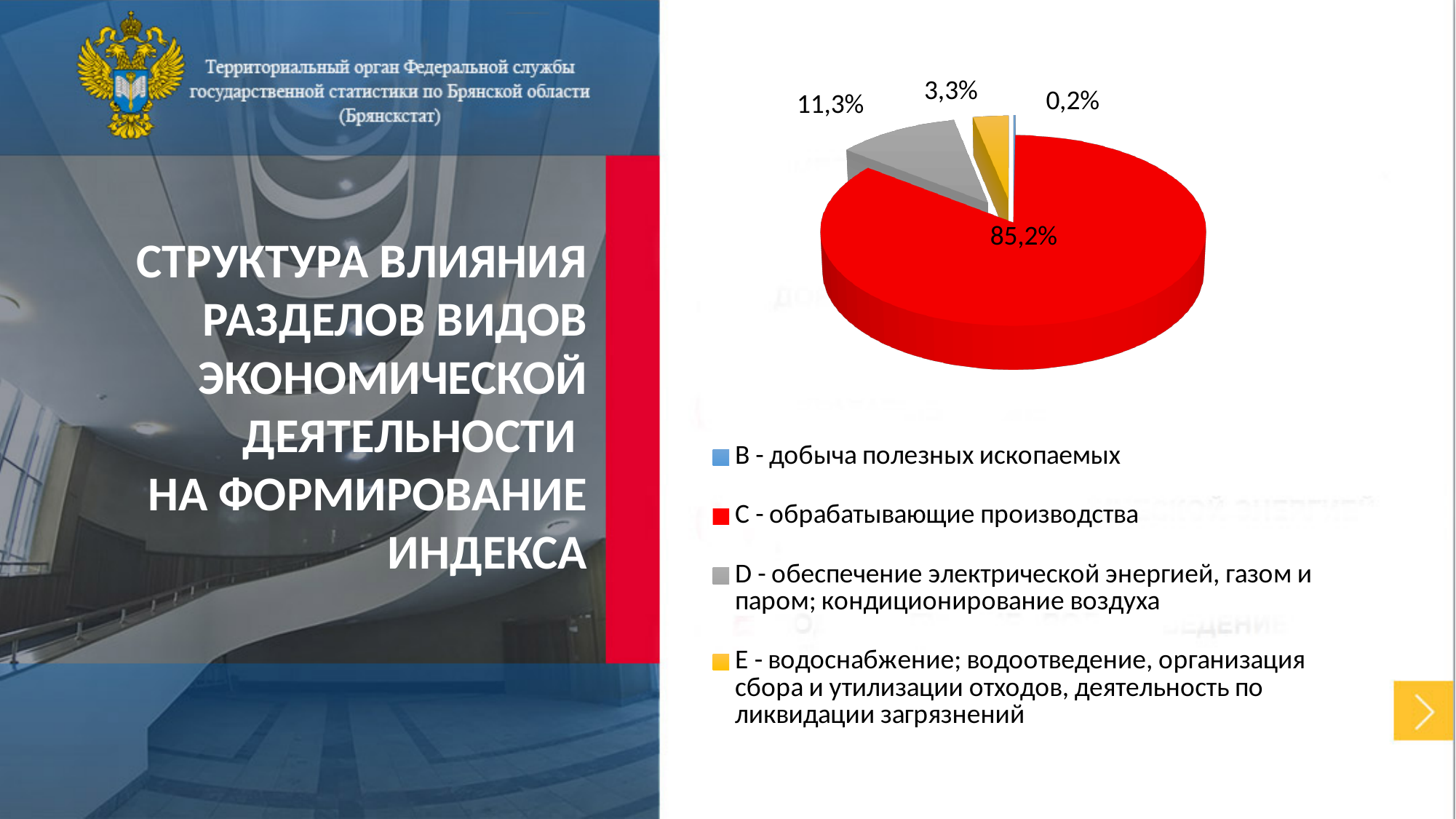
Which category has the largest slice of the pie? C - обрабатывающие производства What is the value shown for E - водоснабжение; водоотведение, организация сбора и утилизации отходов, деятельность по ликвидации загрязнений? 3,3% What is the difference between the shares of C - обрабатывающие производства and D - обеспечение электрической энергией, газом и паром; кондиционирование воздуха? 73,9% What colour is the slice for C - обрабатывающие производства? Red How many categories are shown in the pie chart? 4 What kind of chart is shown on the slide? Pie chart What is the value shown for D - обеспечение электрической энергией, газом и паром; кондиционирование воздуха? 11,3% Which is larger: the share of E - водоснабжение; водоотведение, организация сбора и утилизации отходов, деятельность по ликвидации загрязнений or the share of B - добыча полезных ископаемых? E - водоснабжение; водоотведение, организация сбора и утилизации отходов, деятельность по ликвидации загрязнений What is the difference between the shares of D - обеспечение электрической энергией, газом и паром; кондиционирование воздуха and E - водоснабжение; водоотведение, организация сбора и утилизации отходов, деятельность по ликвидации загрязнений? 8,0% Which category has the smallest slice of the pie? B - добыча полезных ископаемых What is the value shown for B - добыча полезных ископаемых? 0,2% What share of the pie does C - обрабатывающие производства hold? 85,2%